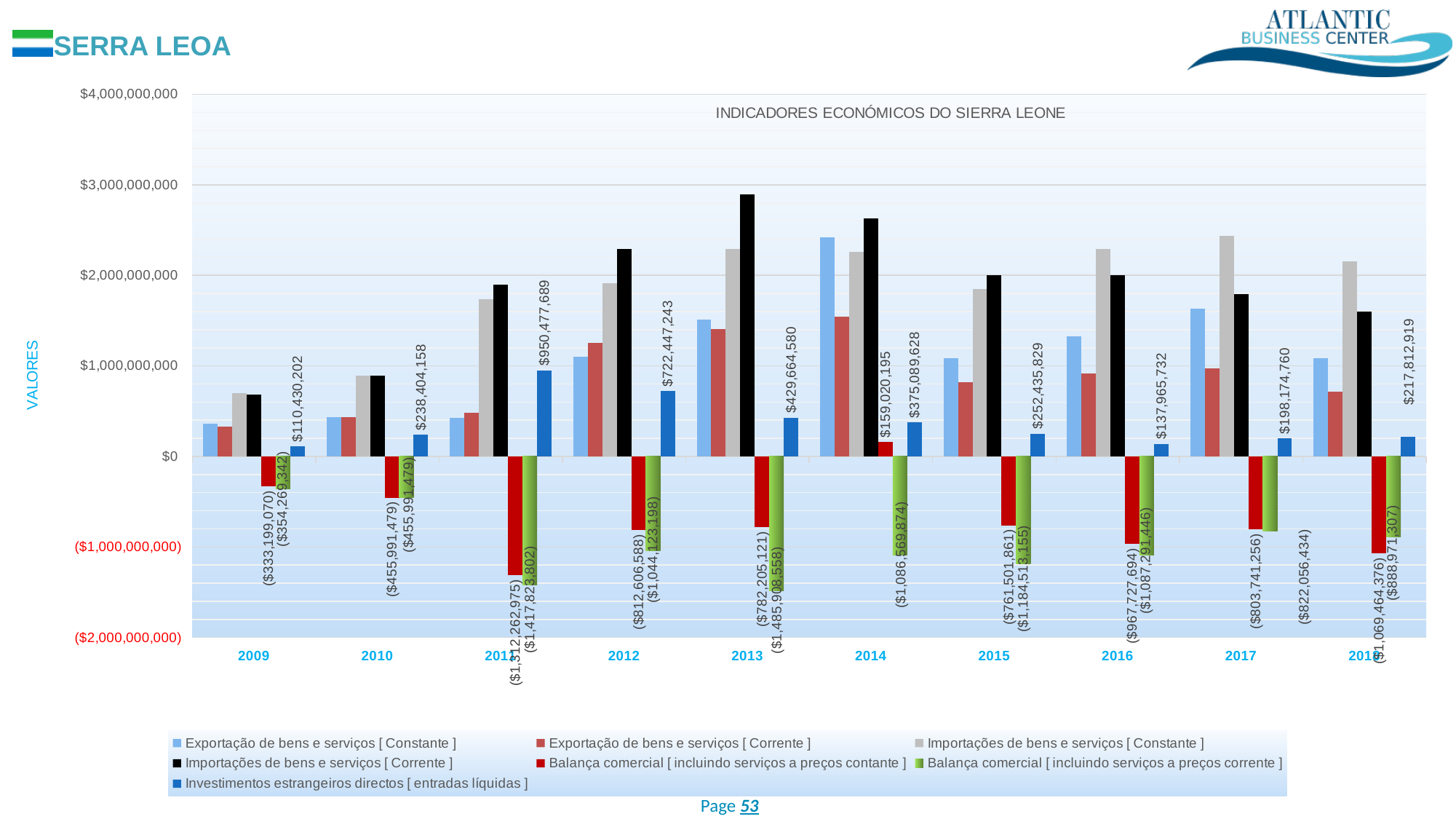
In which year is Investimentos estrangeiros directos [ entradas líquidas ] highest? 2011 Is the value for Importações de bens e serviços [ Corrente ] in 2013 greater or less than $2,000,000,000? greater What is the value of Investimentos estrangeiros directos [ entradas líquidas ] in 2011? $950,477,689 How many years are shown on the x axis of the chart? 10 How many series does the chart legend list? 7 What is the difference between Investimentos estrangeiros directos [ entradas líquidas ] in 2011 and in 2012? $228,030,446 What is the title of the chart? INDICADORES ECONÓMICOS DO SIERRA LEONE What kind of chart is shown on the slide? bar chart What is the value of Balança comercial [ incluindo serviços a preços contante ] in 2014? $159,020,195 What is the value of Balança comercial [ incluindo serviços a preços corrente ] in 2013? ($1,485,908,558) In which year is Importações de bens e serviços [ Corrente ] highest? 2013 In which year is Investimentos estrangeiros directos [ entradas líquidas ] lowest? 2009